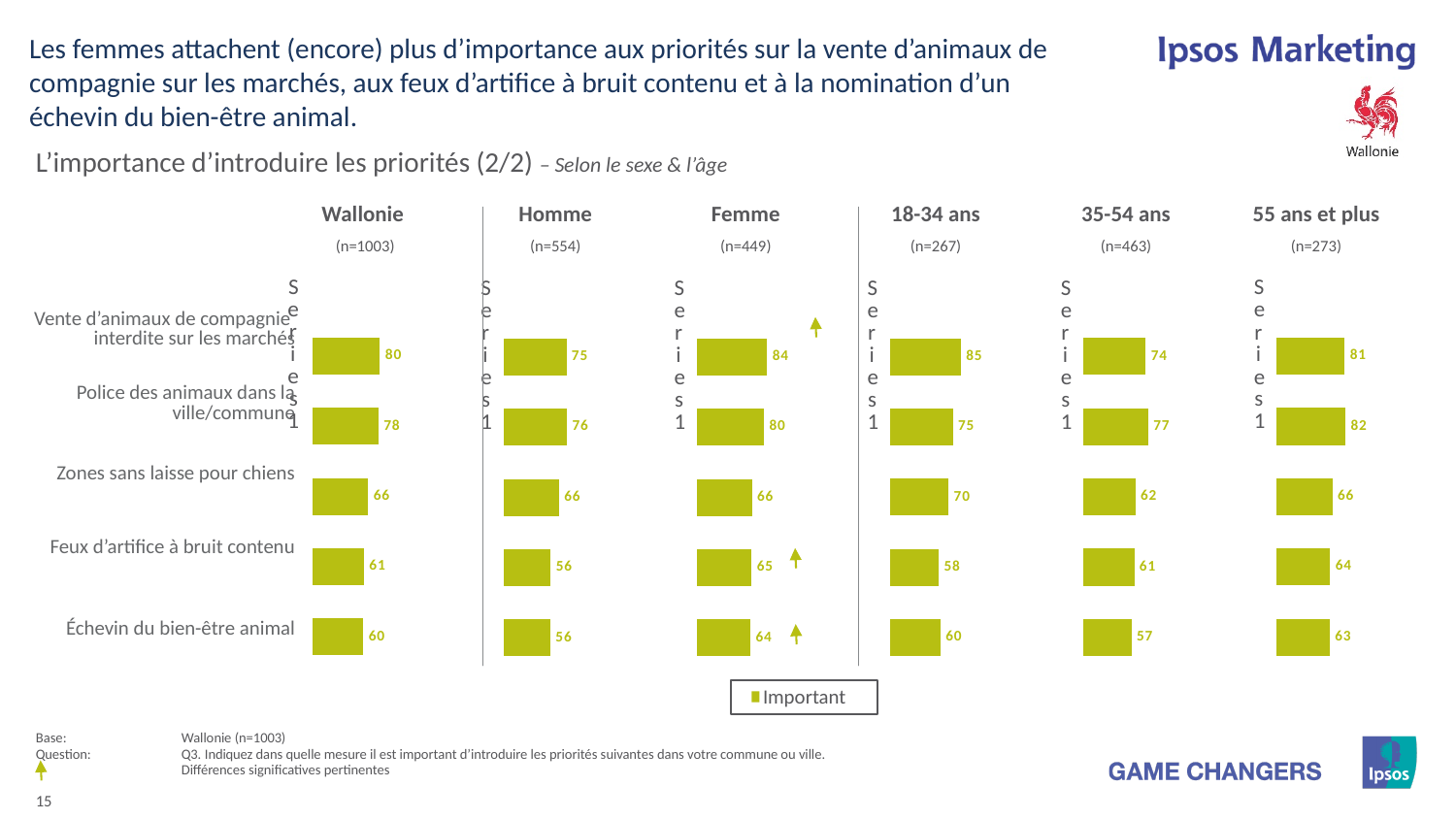
How many series does the legend list? 1 In the 35-54 ans chart, which category has the lowest value? Échevin du bien-être animal What kind of chart is used for the Wallonie panel? Bar chart What is the difference between the Femme and Homme values for "Échevin du bien-être animal"? 8 In the 18-34 ans chart, which category has the highest value? Vente d’animaux de compagnie interdite sur les marchés What is the difference between the 18-34 ans and 35-54 ans values for "Vente d’animaux de compagnie interdite sur les marchés"? 11 For "Police des animaux dans la ville/commune", which is larger: the 55 ans et plus value or the 18-34 ans value? 55 ans et plus In the 55 ans et plus chart, what is the value for "Zones sans laisse pour chiens"? 66 In the Wallonie chart, what is the value for "Vente d’animaux de compagnie interdite sur les marchés"? 80 How many categories are shown in the Homme chart? 5 What is the legend entry shown below the charts? Important In the Femme chart, what is the value for "Feux d’artifice à bruit contenu"? 65